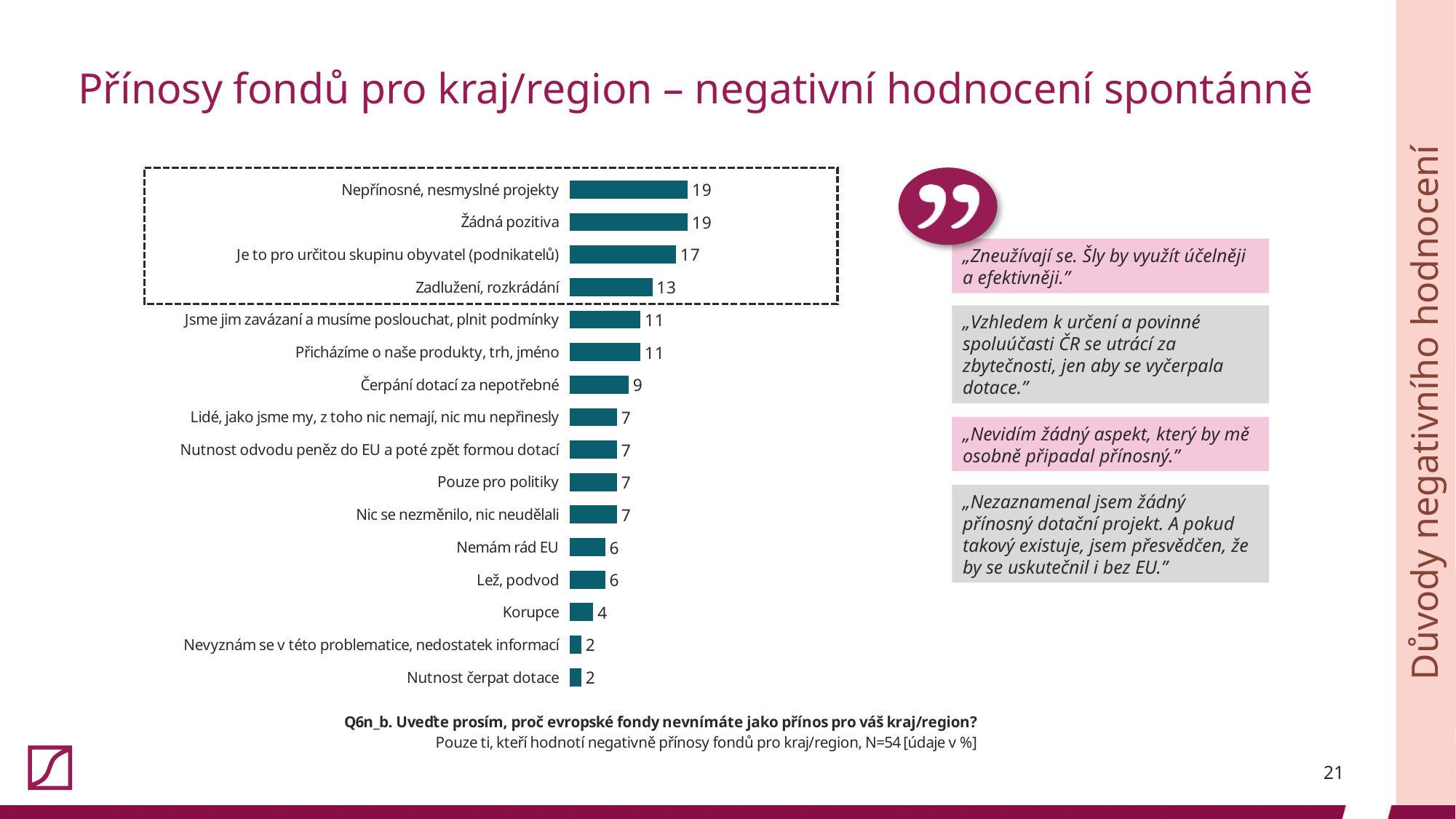
What is the value for "Zadlužení, rozkrádání"? 13 How many categories are plotted in the chart? 16 What is the value for "Čerpání dotací za nepotřebné"? 9 Which two categories share the highest value in the chart? Nepřínosné, nesmyslné projekty and Žádná pozitiva What type of chart is shown on the slide? bar chart What is the value for "Nemám rád EU"? 6 How many categories are enclosed in the dashed box at the top of the chart? 4 What is the difference between the values for "Žádná pozitiva" and "Zadlužení, rozkrádání"? 6 Do the values rise or fall going from the top category to the bottom category? fall What is the value for "Korupce"? 4 What is the value for "Je to pro určitou skupinu obyvatel (podnikatelů)"? 17 Which is larger, the value for "Přicházíme o naše produkty, trh, jméno" or the value for "Pouze pro politiky"? Přicházíme o naše produkty, trh, jméno